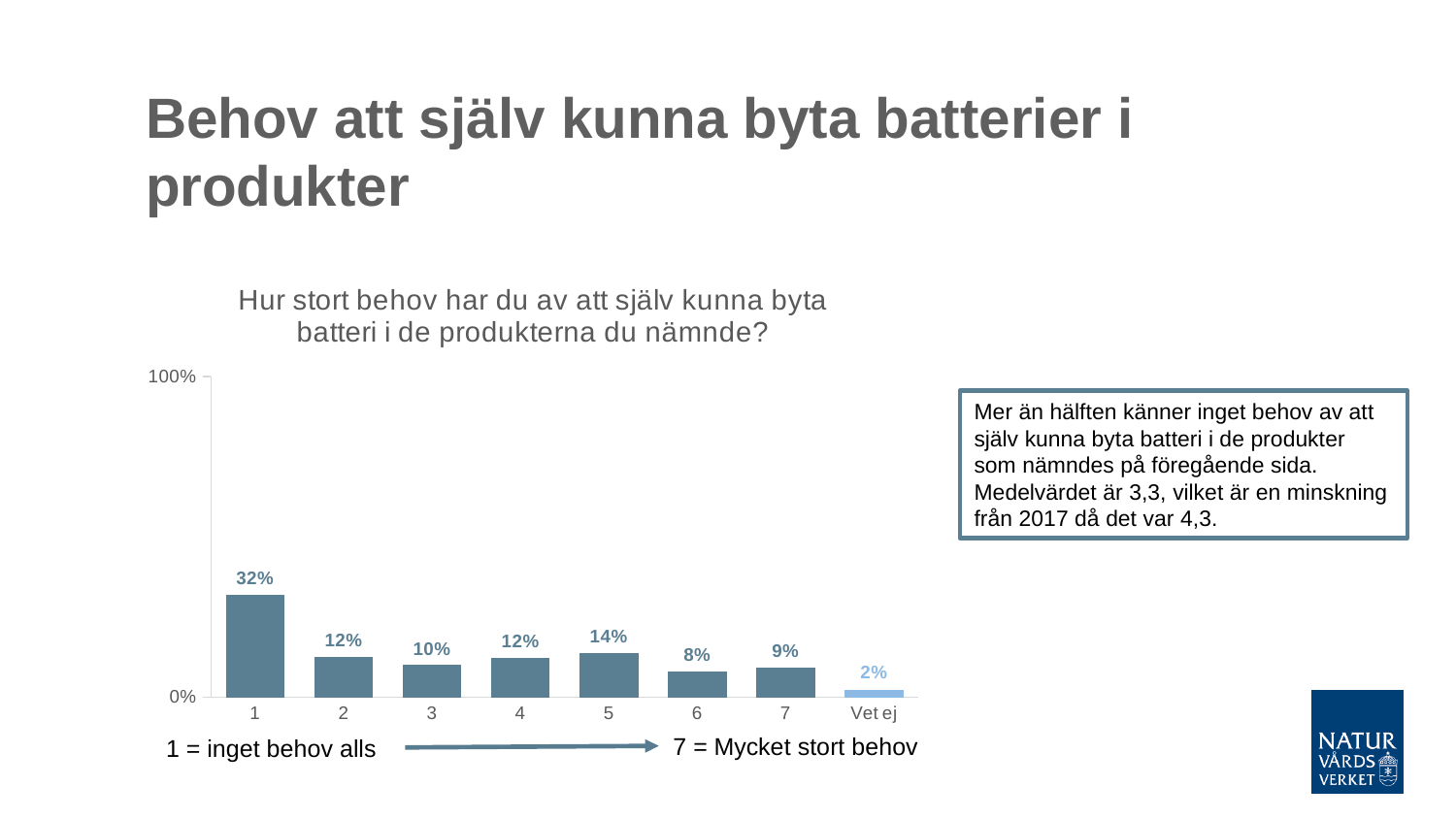
How many categories are shown on the x axis? 8 Which category has the highest value? 1 What is the difference between the values for category 5 and category 6? 6% Which category has the lowest value? Vet ej What is the value for category 5? 14% What kind of chart is shown on the slide? Bar chart What percentage of respondents answered 1 (inget behov alls)? 32% What is the value for 'Vet ej'? 2% Which is larger, the value for category 6 or category 7? 7 What is the maximum value shown on the y axis? 100% What is the difference between the values for category 1 and category 2? 20% What is the title of the chart? Hur stort behov har du av att själv kunna byta batteri i de produkterna du nämnde?